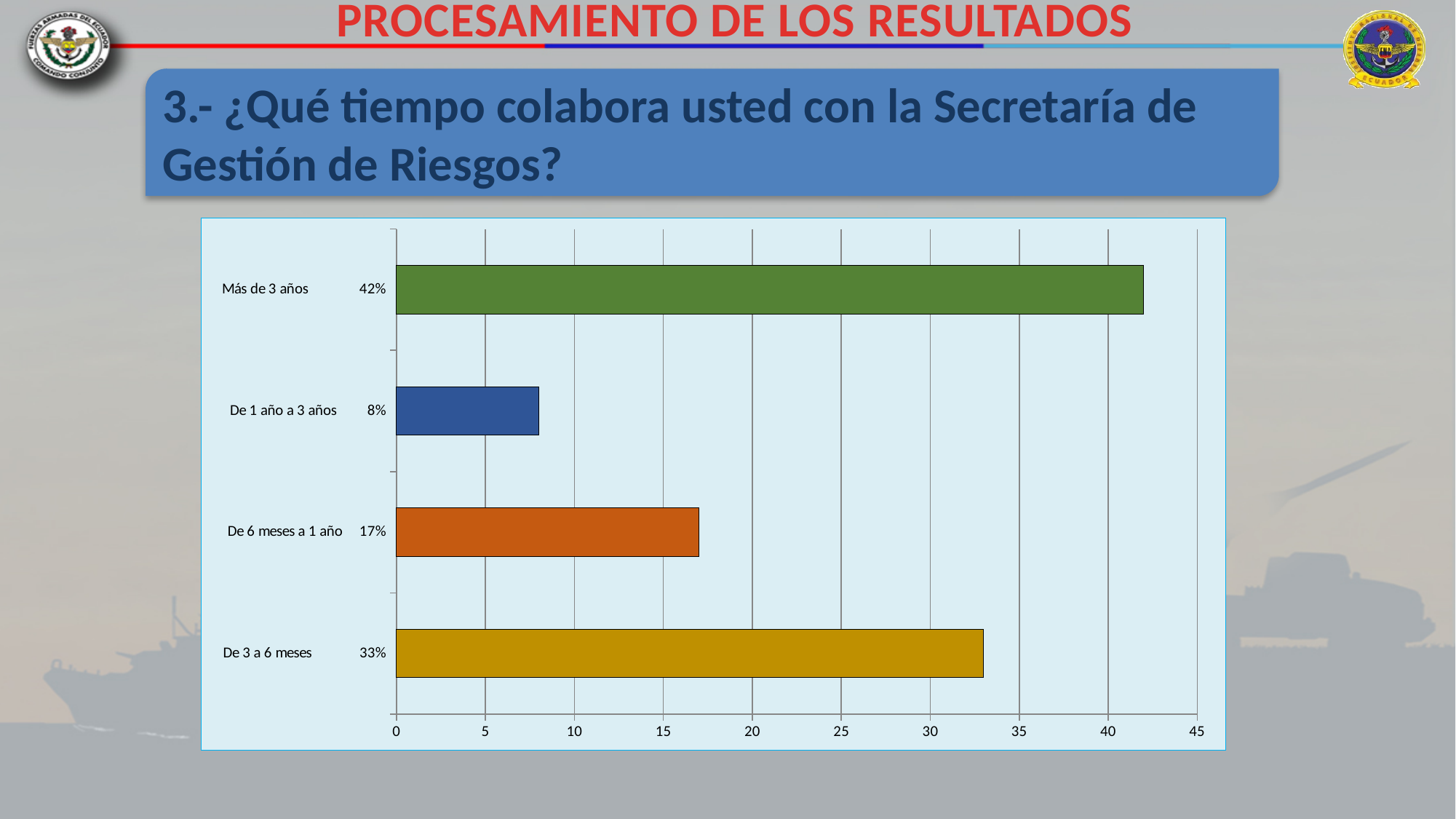
What kind of chart is shown on the slide? Bar chart What is the value for "De 6 meses a 1 año"? 17% What is the value for "De 1 año a 3 años"? 8% What is the value for "Más de 3 años"? 42% Which category has the lowest value? De 1 año a 3 años Is the value for "Más de 3 años" greater or less than 40? greater Which category has the highest value? Más de 3 años Which is larger, the value for "De 3 a 6 meses" or the value for "De 6 meses a 1 año"? De 3 a 6 meses How many categories are shown in the chart? 4 What is the difference between the values for "Más de 3 años" and "De 3 a 6 meses"? 9% What is the difference between the values for "De 6 meses a 1 año" and "De 1 año a 3 años"? 9% What is the value for "De 3 a 6 meses"? 33%